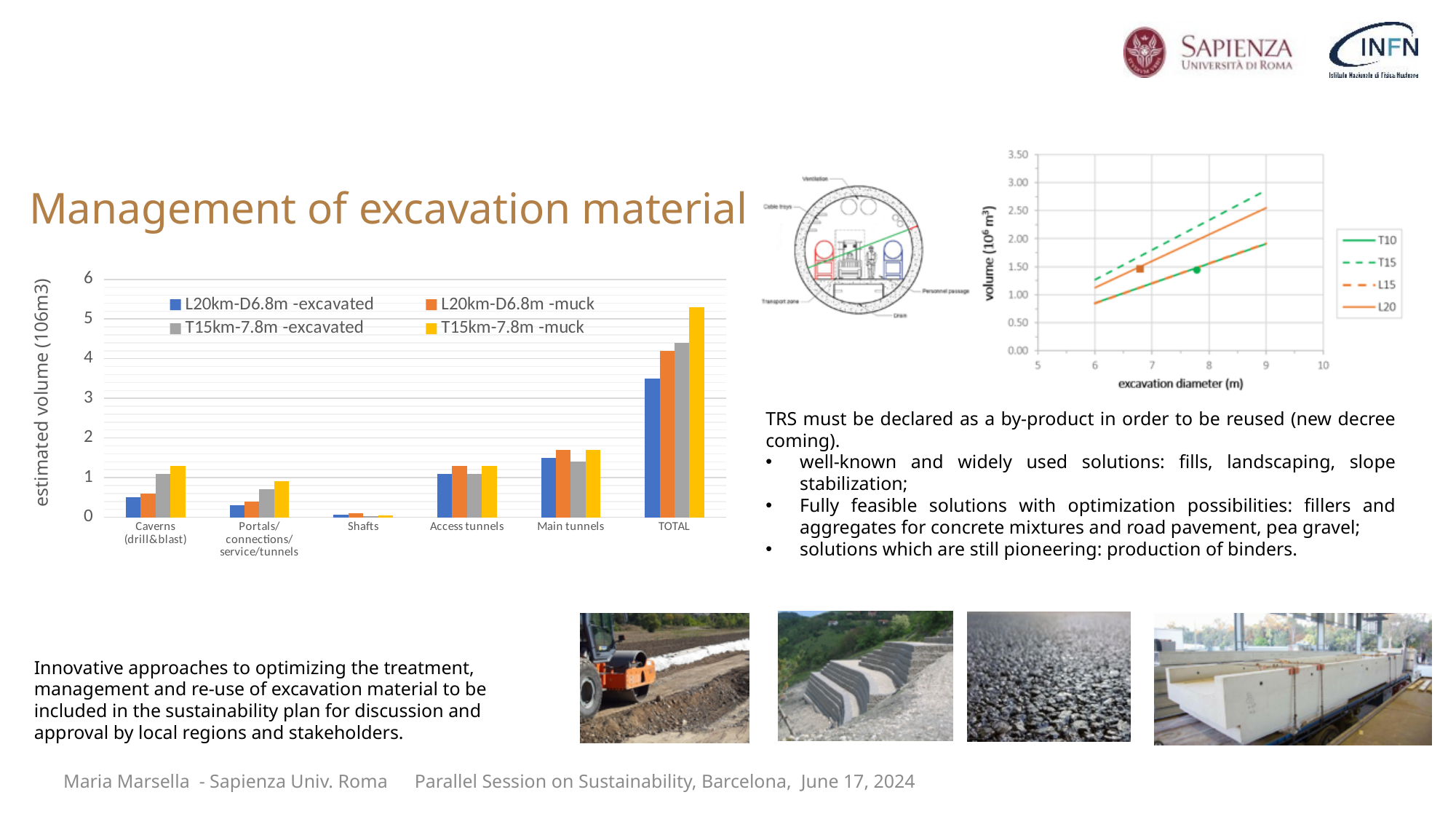
In the bar chart on the left, for Caverns (drill&blast), which is larger: L20km-D6.8m -excavated or T15km-7.8m -excavated? T15km-7.8m -excavated In the bar chart on the left, is the TOTAL value for T15km-7.8m -muck greater or less than 5? greater In the bar chart on the left, which category has the highest value for T15km-7.8m -muck? TOTAL In the bar chart on the left, which category has the lowest values across all series? Shafts In the bar chart on the left, is the TOTAL value for L20km-D6.8m -excavated greater or less than 4? less In the bar chart on the left, how many series does the legend list? 4 In the bar chart on the left, how many categories are shown on the x axis? 6 In the bar chart on the left, what kind of chart is it? bar chart In the bar chart on the left, is the Caverns (drill&blast) value for T15km-7.8m -muck greater or less than 1? greater In the line chart on the right, how many series does the legend list? 4 In the bar chart on the left, for L20km-D6.8m -excavated, which is larger: Access tunnels or Main tunnels? Main tunnels In the line chart on the right, does volume rise or fall as excavation diameter increases? rise